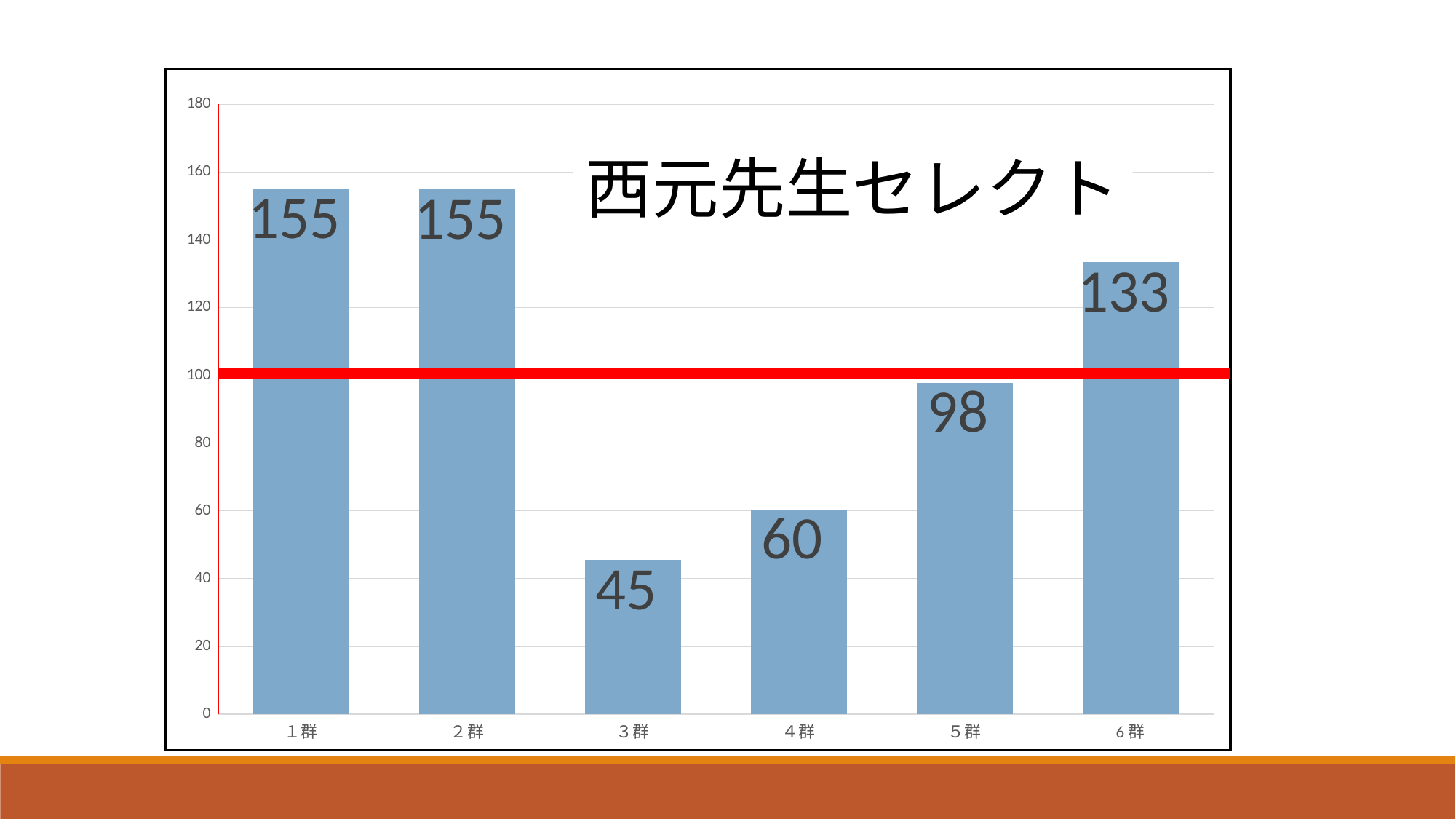
What is the value for 3群? 45 Which category has the lowest value? 3群 How many categories are shown on the x axis? 6 What kind of chart is shown on the slide? bar chart What is the value for 5群? 98 What is the difference between the values for 1群 and 4群? 95 What is the value for 6群? 133 Which is larger, the value for 4群 or the value for 5群? 5群 What is the difference between the values for 6群 and 5群? 35 Is the value for 6群 greater or less than 100? greater What text is written inside the chart area above the bars? 西元先生セレクト Is the value for 5群 greater or less than 100? less